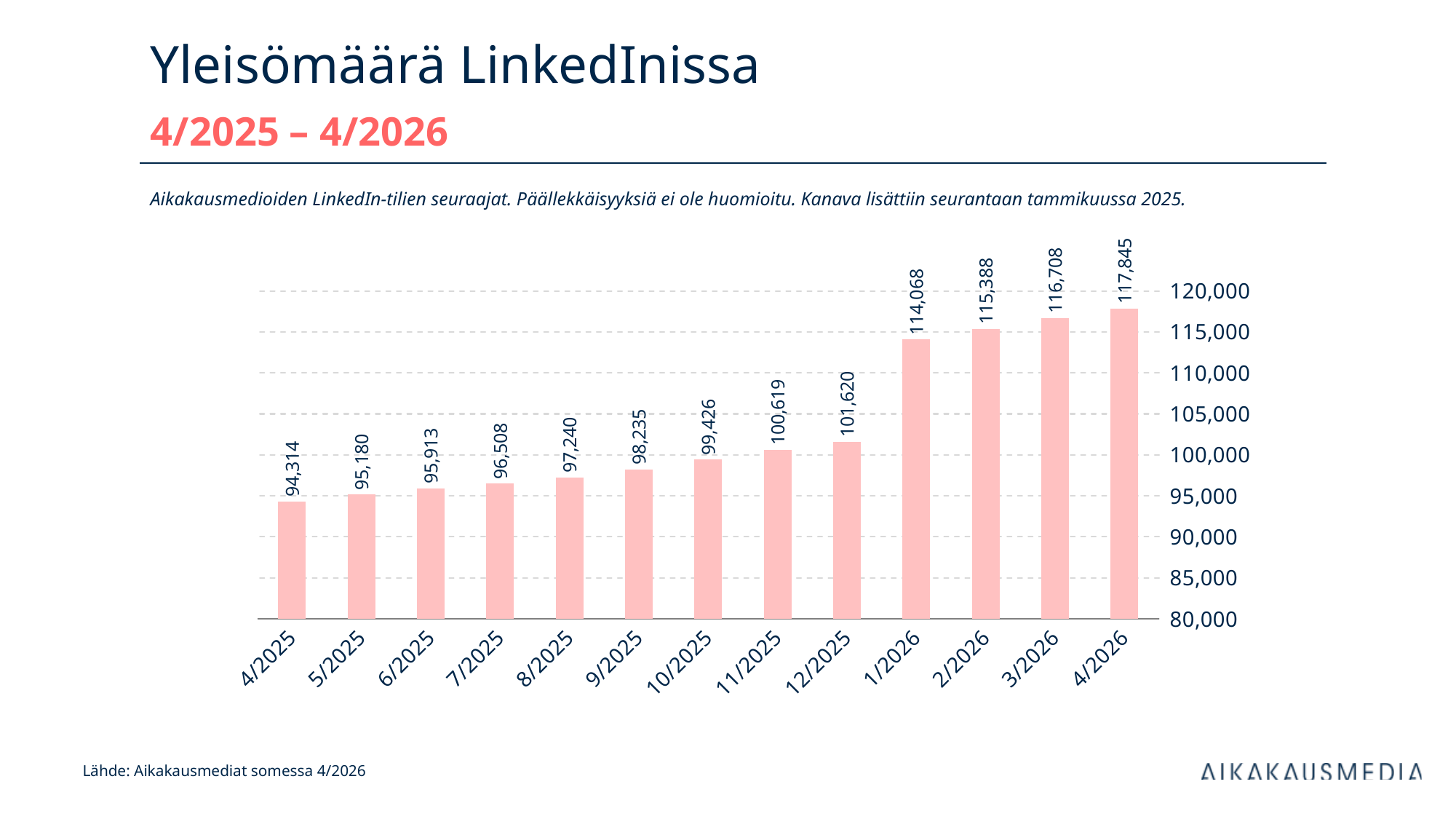
Do the values rise or fall from 4/2025 to 4/2026? rise Which month has the highest value? 4/2026 What is the value for 4/2025? 94,314 Which is larger, the value for 8/2025 or the value for 11/2025? 11/2025 How many months are shown on the x axis? 13 What is the difference between the values for 1/2026 and 12/2025? 12,448 What is the difference between the values for 4/2026 and 4/2025? 23,531 What is the value for 1/2026? 114,068 What is the value for 10/2025? 99,426 What kind of chart is shown on the slide? bar chart Is the value for 2/2026 greater or less than 110,000? greater Which month has the lowest value? 4/2025